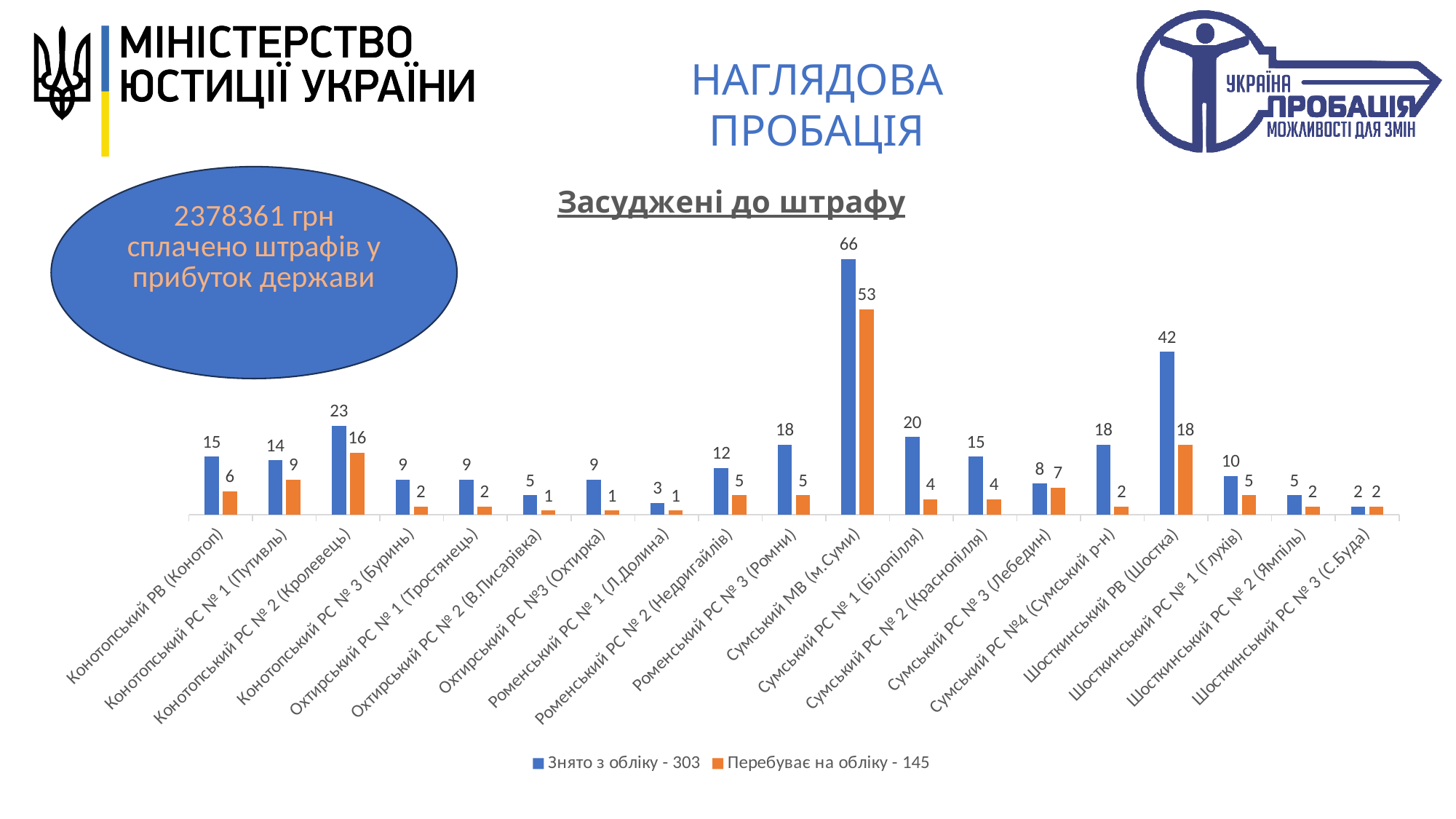
What is the difference between "Знято з обліку" for Шосткинський РВ (Шостка) and for Сумський РС № 1 (Білопілля)? 22 What is the difference between "Знято з обліку" and "Перебуває на обліку" for Сумський МВ (м.Суми)? 13 What is the title of the chart? Засуджені до штрафу Which category has the lowest value for "Знято з обліку"? Шосткинський РС № 3 (С.Буда) Which category has the highest value for "Знято з обліку"? Сумський МВ (м.Суми) How many series does the legend list? 2 What kind of chart is shown on the slide? Bar chart What is the value of "Знято з обліку" for Конотопський РС № 2 (Кролевець)? 23 Which is larger: "Знято з обліку" for Роменський РС № 3 (Ромни) or for Роменський РС № 2 (Недригайлів)? Роменський РС № 3 (Ромни) What is the value of "Знято з обліку" for Сумський МВ (м.Суми)? 66 How many categories are shown on the x axis of the chart? 19 What is the value of "Перебуває на обліку" for Шосткинський РВ (Шостка)? 18